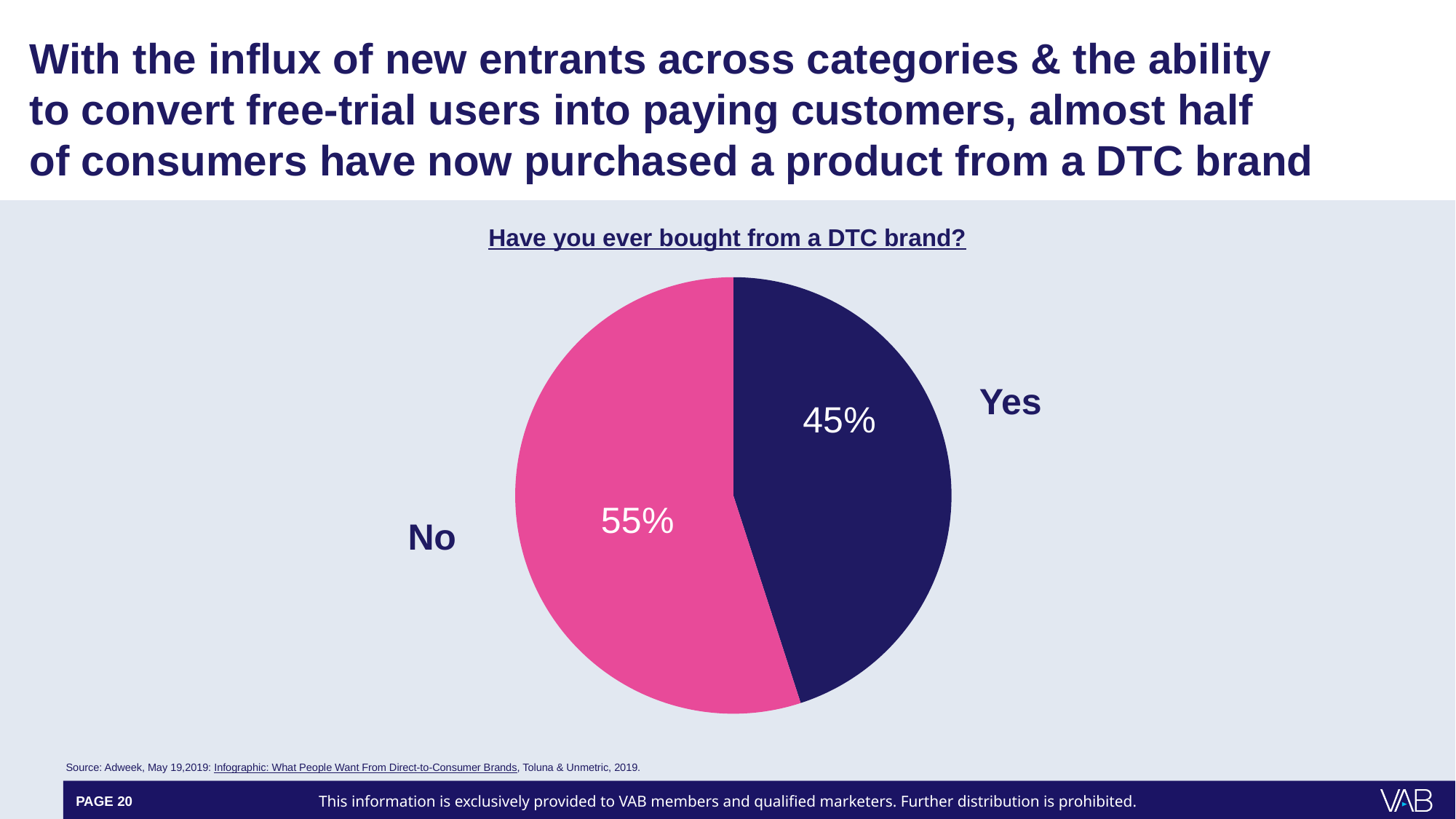
How many slices does the pie chart have? 2 What is the difference in percentage points between the "No" and "Yes" slices? 10 What share of the pie does the "No" slice represent? 55% Is the "Yes" slice larger or smaller than the "No" slice? smaller What percentage of respondents answered "Yes" to having bought from a DTC brand? 45% What percentage of respondents answered "No"? 55% What kind of chart is shown on the slide? pie chart What is the title of the pie chart? Have you ever bought from a DTC brand? Which response has the larger share of the pie? No Which response has the smaller share of the pie? Yes What colour is the "Yes" slice of the pie chart? dark navy blue